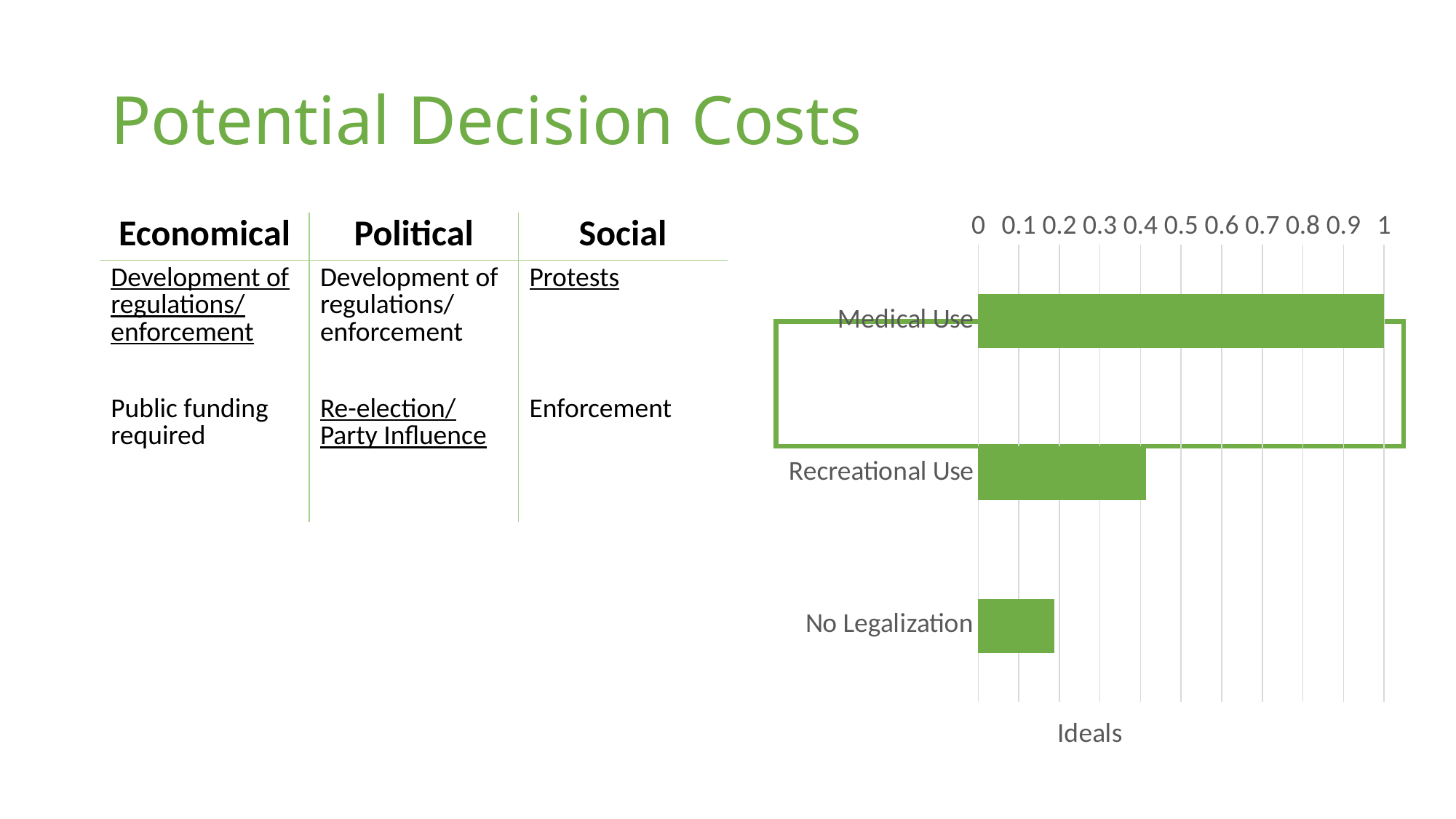
How many categories are plotted in the chart? 3 Is the value for Medical Use greater or less than 0.8? greater Which has a larger value, Recreational Use or No Legalization? Recreational Use Is the value for Recreational Use greater or less than 0.3? greater What is the value for Medical Use in the chart? 1 Is the value for Recreational Use greater or less than 0.5? less What kind of chart is shown on the slide? bar chart Which category has the lowest value in the chart? No Legalization Which category has the highest value in the chart? Medical Use